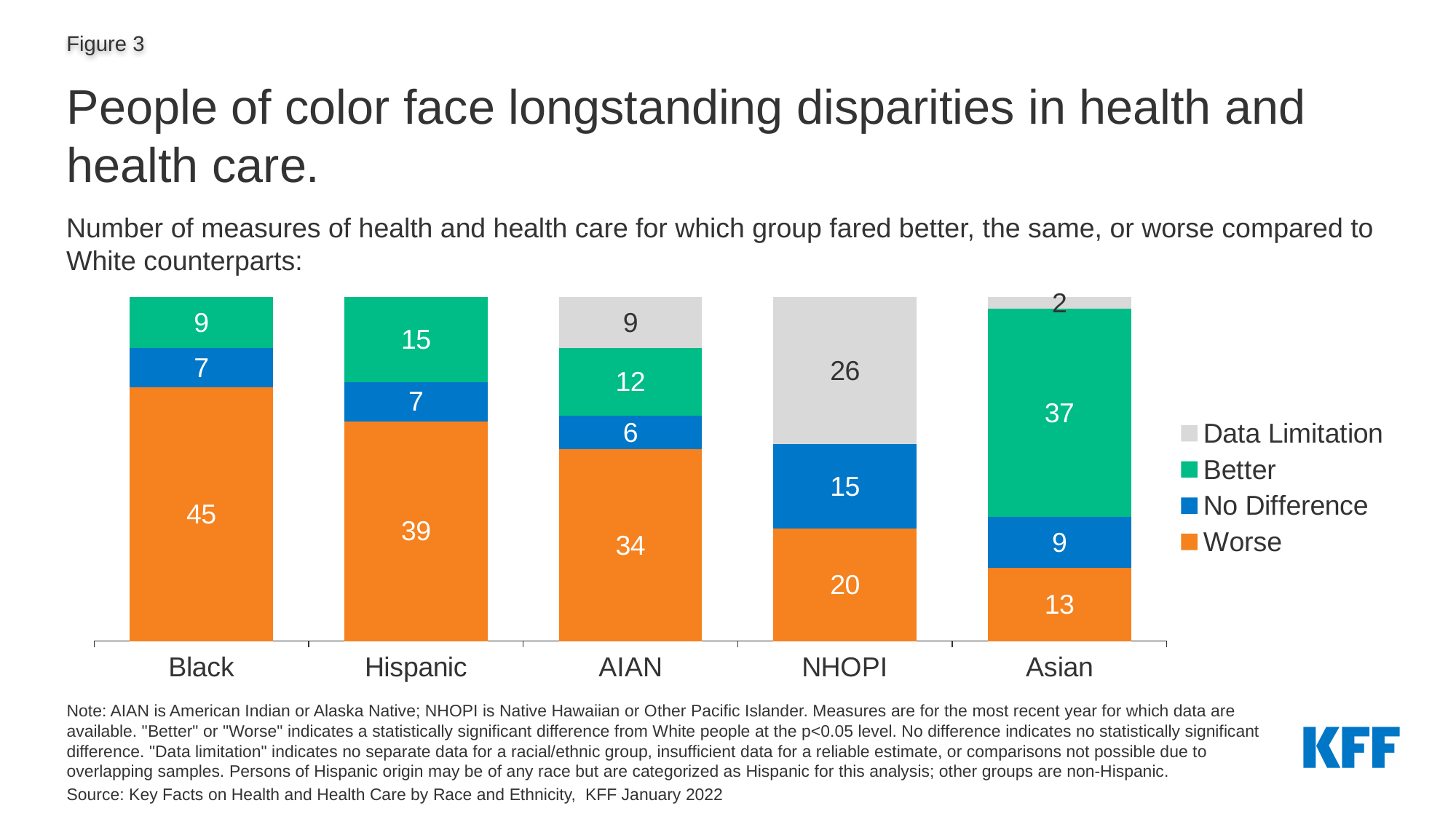
Which group has the lowest Worse value? Asian Which group has the highest Worse value? Black What is the Data Limitation value for NHOPI? 26 What is the No Difference value for AIAN? 6 Which is larger, the Better value for Hispanic or the Better value for AIAN? Hispanic What is the Better value for the Asian group? 37 What is the total of the stacked bar for NHOPI? 61 What type of chart is shown on the slide? stacked bar chart How many series does the legend list? 4 What is the Worse value for the Black group? 45 What is the difference between the Worse values for Black and Hispanic? 6 How many racial/ethnic groups are shown on the x axis? 5